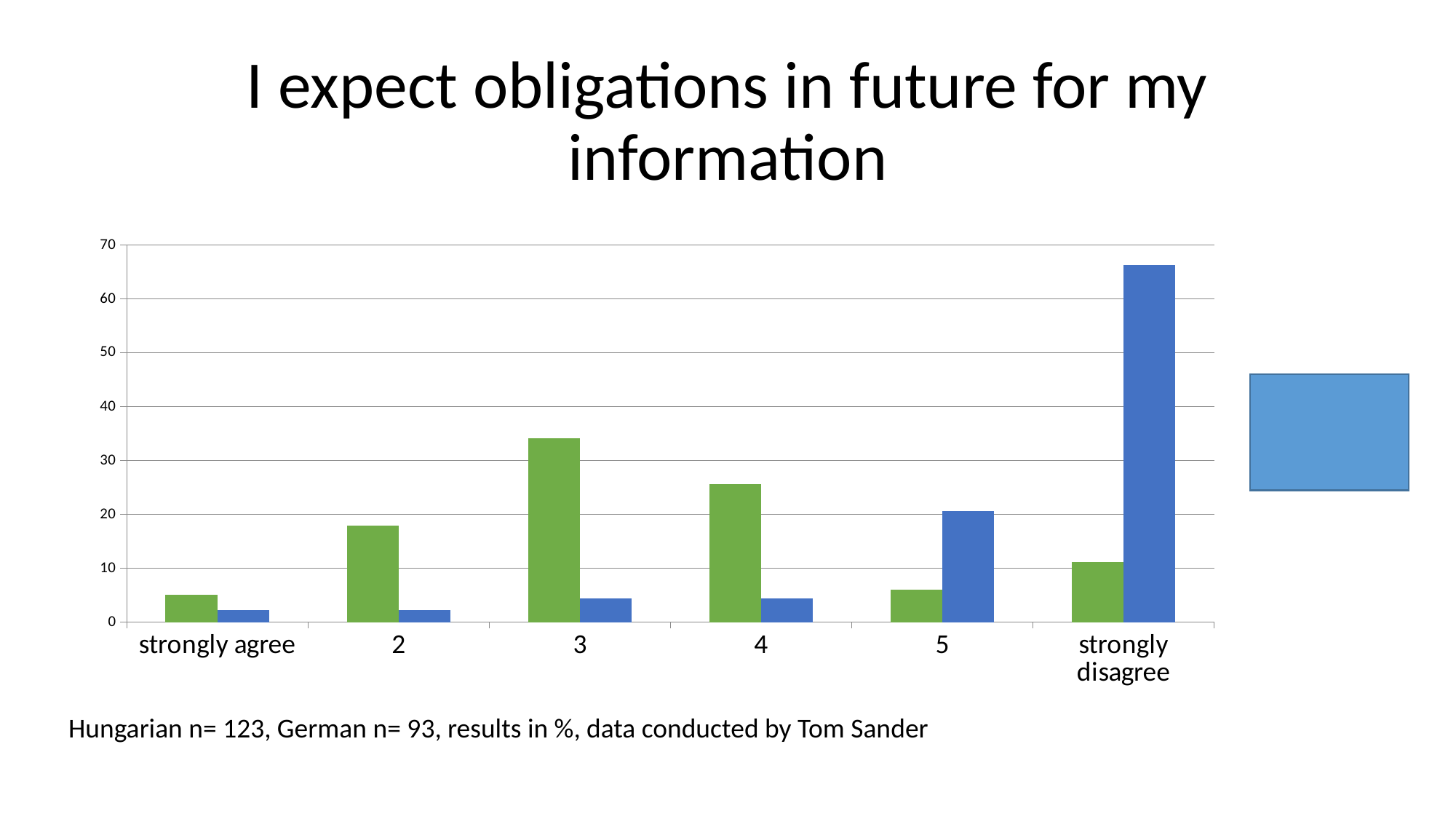
What is the title of the chart on the slide? I expect obligations in future for my information For the 'strongly disagree' category, which bar is larger, the green or the blue? blue Which category has the highest green bar? 3 What kind of chart is shown on the slide? bar chart Do the blue bars generally rise or fall from 'strongly agree' to 'strongly disagree'? rise Is the value of the green bar for category 2 greater or less than 20? less Is the value of the green bar for category 3 greater or less than 30? greater Is the value of the blue bar for 'strongly disagree' greater or less than 60? greater For category 3, which bar is larger, the green or the blue? green Which category has the highest blue bar? strongly disagree How many categories are shown on the x axis of the chart? 6